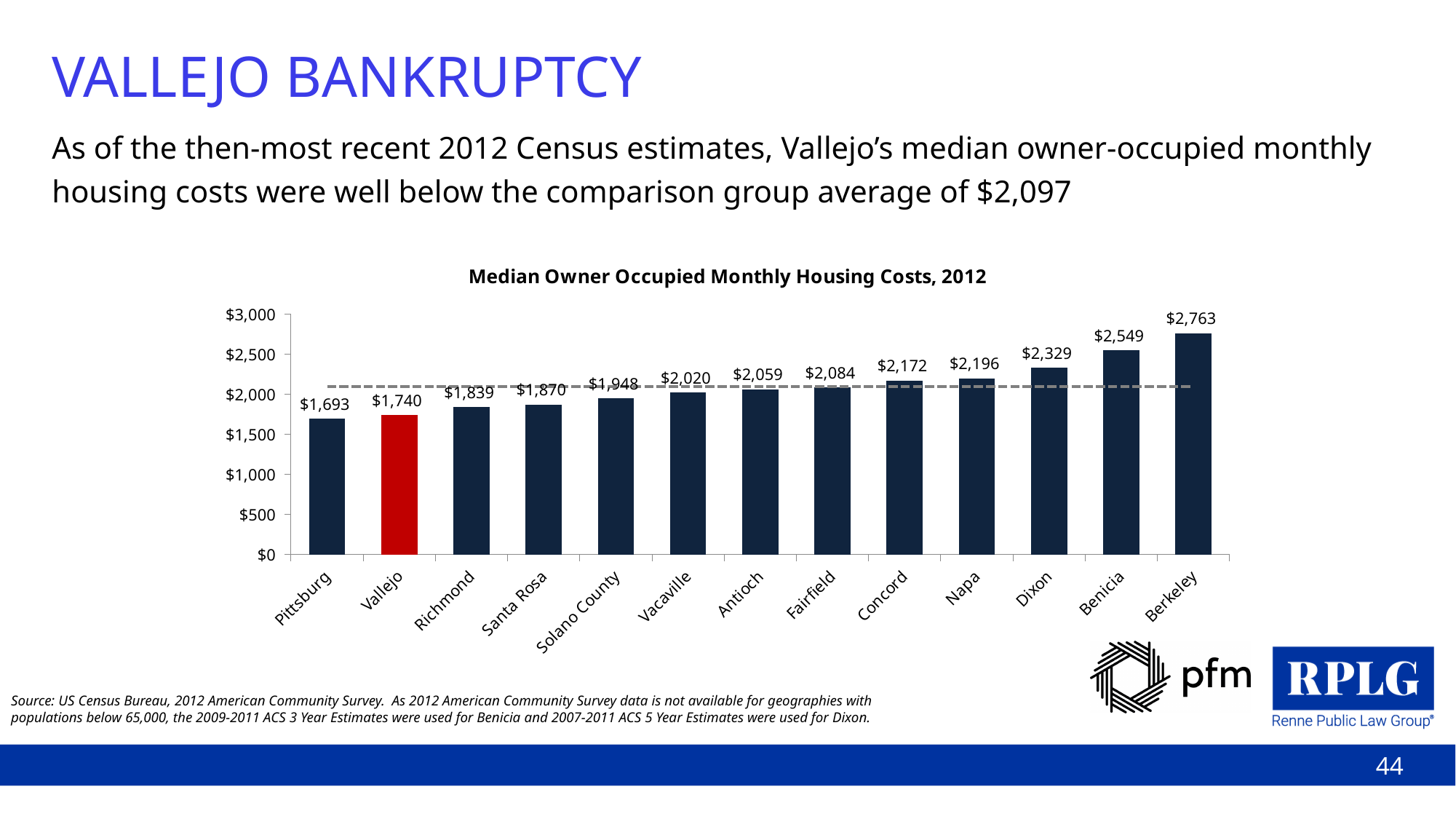
What is the difference between Berkeley's and Vallejo's values? $1,023 Which city has the lowest median owner occupied monthly housing cost? Pittsburg What is the difference between Vallejo's and Pittsburg's values? $47 Is the value for Dixon greater or less than $2,000? greater Which city has the highest median owner occupied monthly housing cost? Berkeley What is the value shown for Solano County? $1,948 How many cities or counties are shown on the chart? 13 Which bar is highlighted in red? Vallejo What is the value shown for Berkeley? $2,763 What is the median owner occupied monthly housing cost for Vallejo? $1,740 What type of chart is shown on the slide? Bar chart Which has a higher value, Napa or Concord? Napa